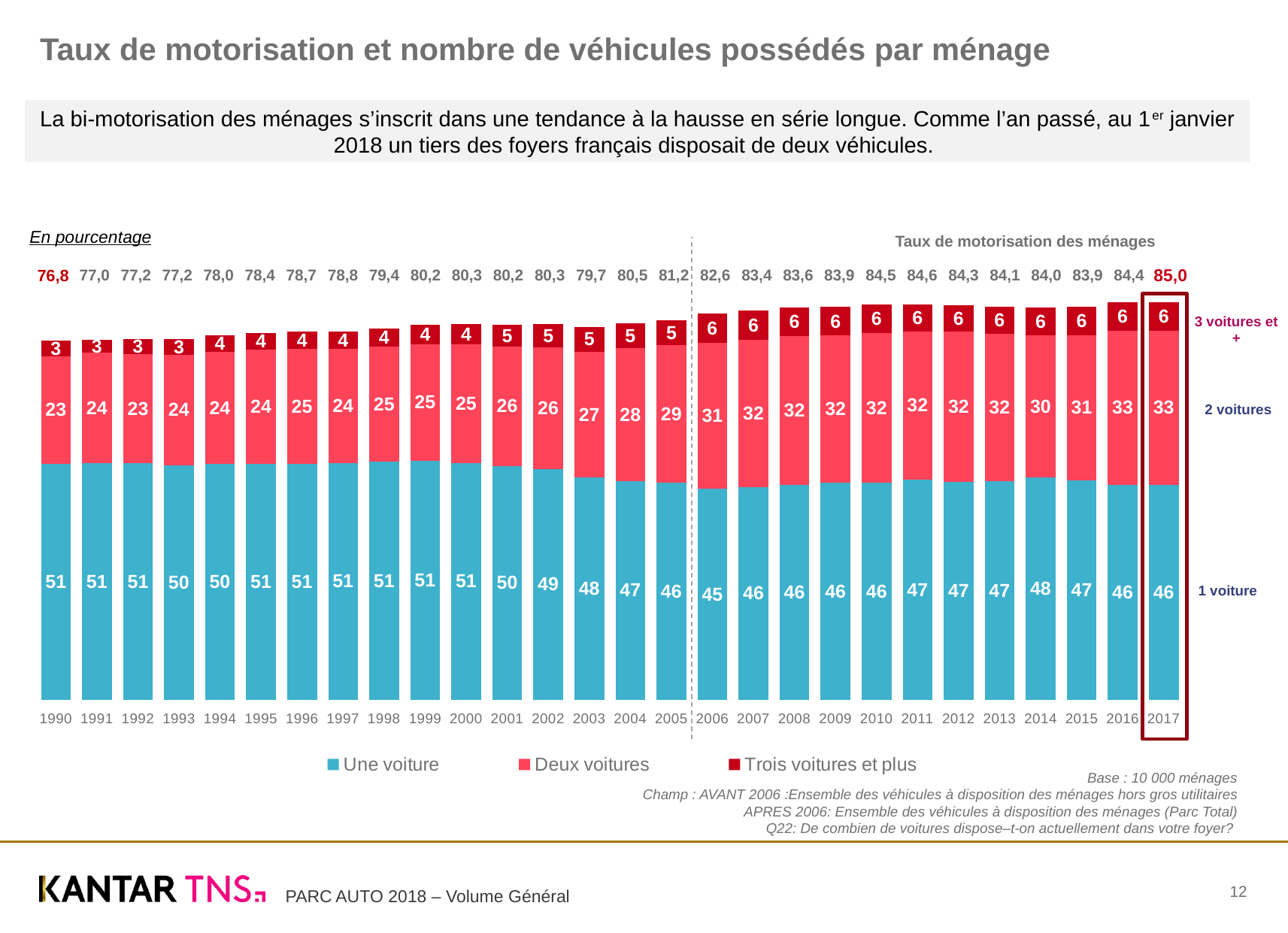
In which year is the "Taux de motorisation des ménages" value highest? 2017 What is the value for "Trois voitures et plus" in 1990? 3 What is the value for "Deux voitures" in 2017? 33 In which year is the "Une voiture" value lowest? 2006 What is the total of the stacked bar for 2017? 85 How many series does the legend list? 3 What kind of chart is shown on the slide? Stacked bar chart What is the value for "Une voiture" in 2017? 46 How many years are shown on the x axis of the chart? 28 Which is larger, the "Une voiture" value in 1990 or in 2017? 1990 What is the difference between the "Deux voitures" value in 2017 and in 1990? 10 What is the "Taux de motorisation des ménages" shown for 2017? 85,0